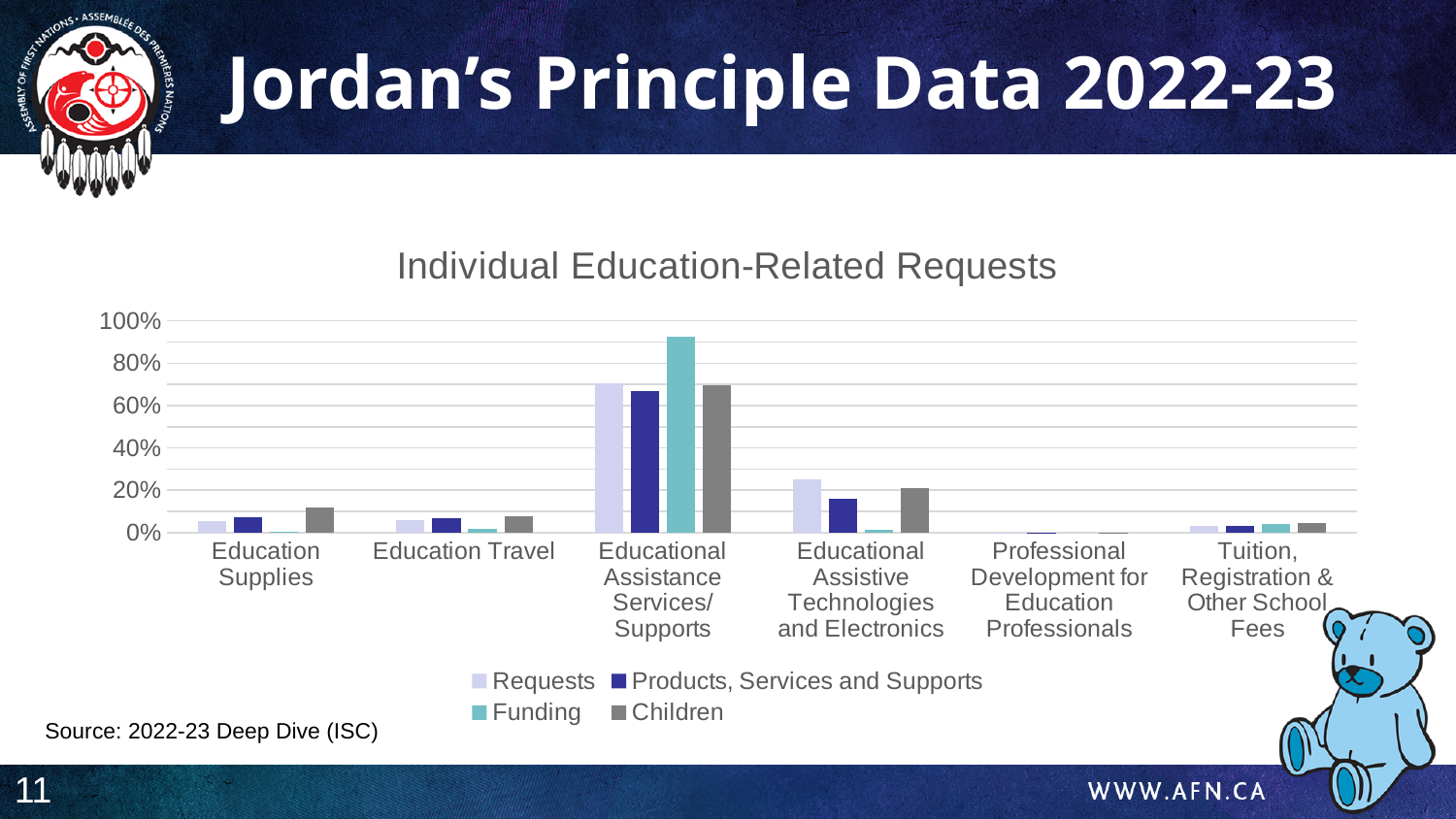
How many categories are shown along the x axis of the chart? 6 Which category has the lowest values across all series? Professional Development for Education Professionals How many series does the chart's legend list? 4 What is the title of the chart? Individual Education-Related Requests For Education Supplies, which is larger: Children or Funding? Children Is the Requests value for Educational Assistive Technologies and Electronics greater or less than 20%? greater Which category has the highest Funding value? Educational Assistance Services/Supports Is the Funding value for Educational Assistance Services/Supports greater or less than 80%? greater What source is cited for the chart data? 2022-23 Deep Dive (ISC) For Educational Assistive Technologies and Electronics, which is larger: Requests or Products, Services and Supports? Requests Is the Children value for Education Supplies greater or less than 20%? less What kind of chart is shown on the slide? Bar chart